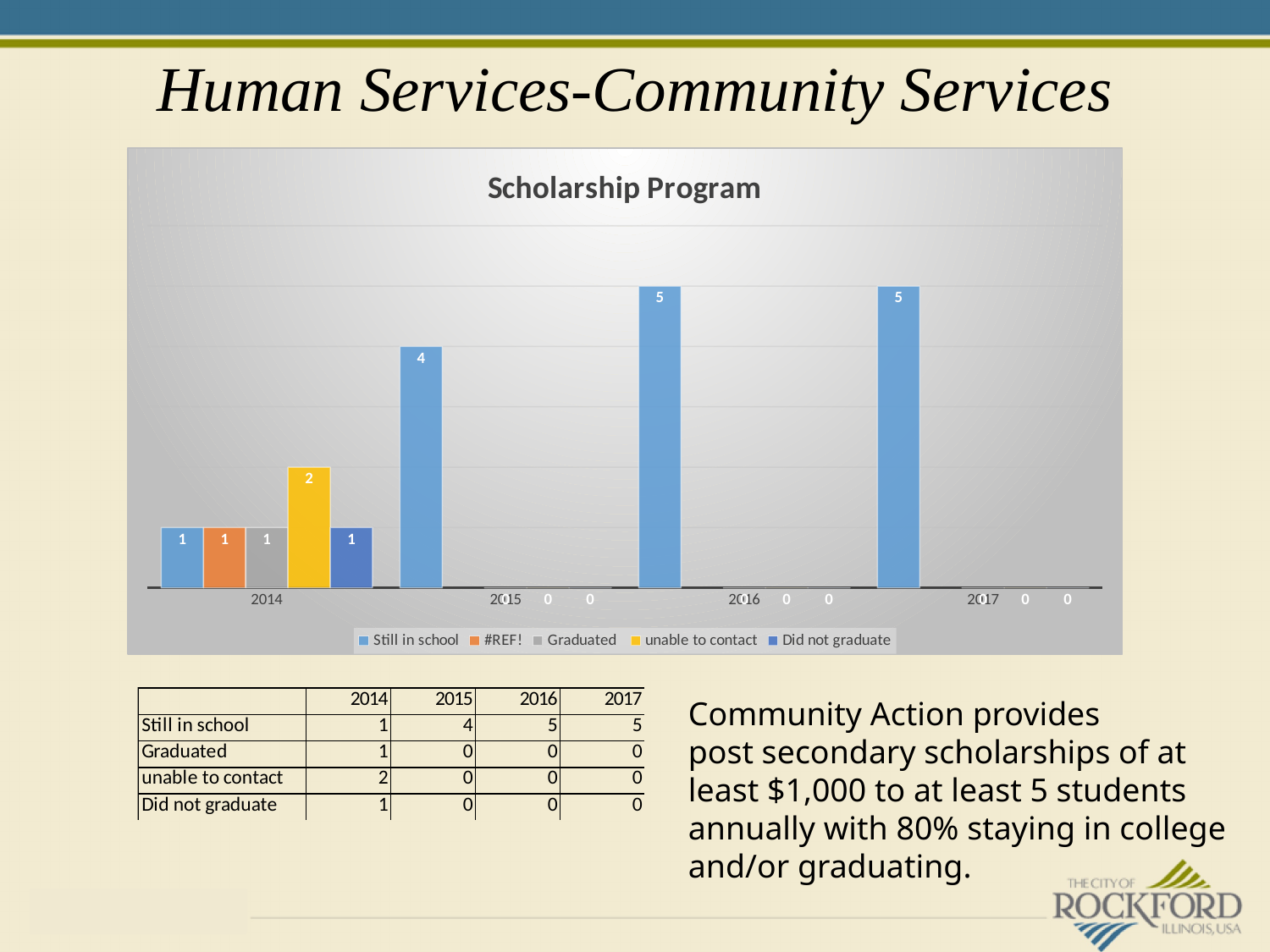
In which year is the "Still in school" value lowest? 2014 Which is larger in 2014: the value for "unable to contact" or the value for "Did not graduate"? unable to contact What is the value for "Still in school" in 2016? 5 What is the chart's title? Scholarship Program How many series does the legend list? 5 What is the value for "unable to contact" in 2014? 2 Does the "Still in school" value rise or fall from 2014 to 2016? rise How many year categories are shown on the x axis? 4 What is the difference between the "Still in school" values for 2016 and 2014? 4 What type of chart is shown under the title "Scholarship Program"? bar chart What is the value for "Graduated" in 2014? 1 What is the value for "Still in school" in 2015? 4